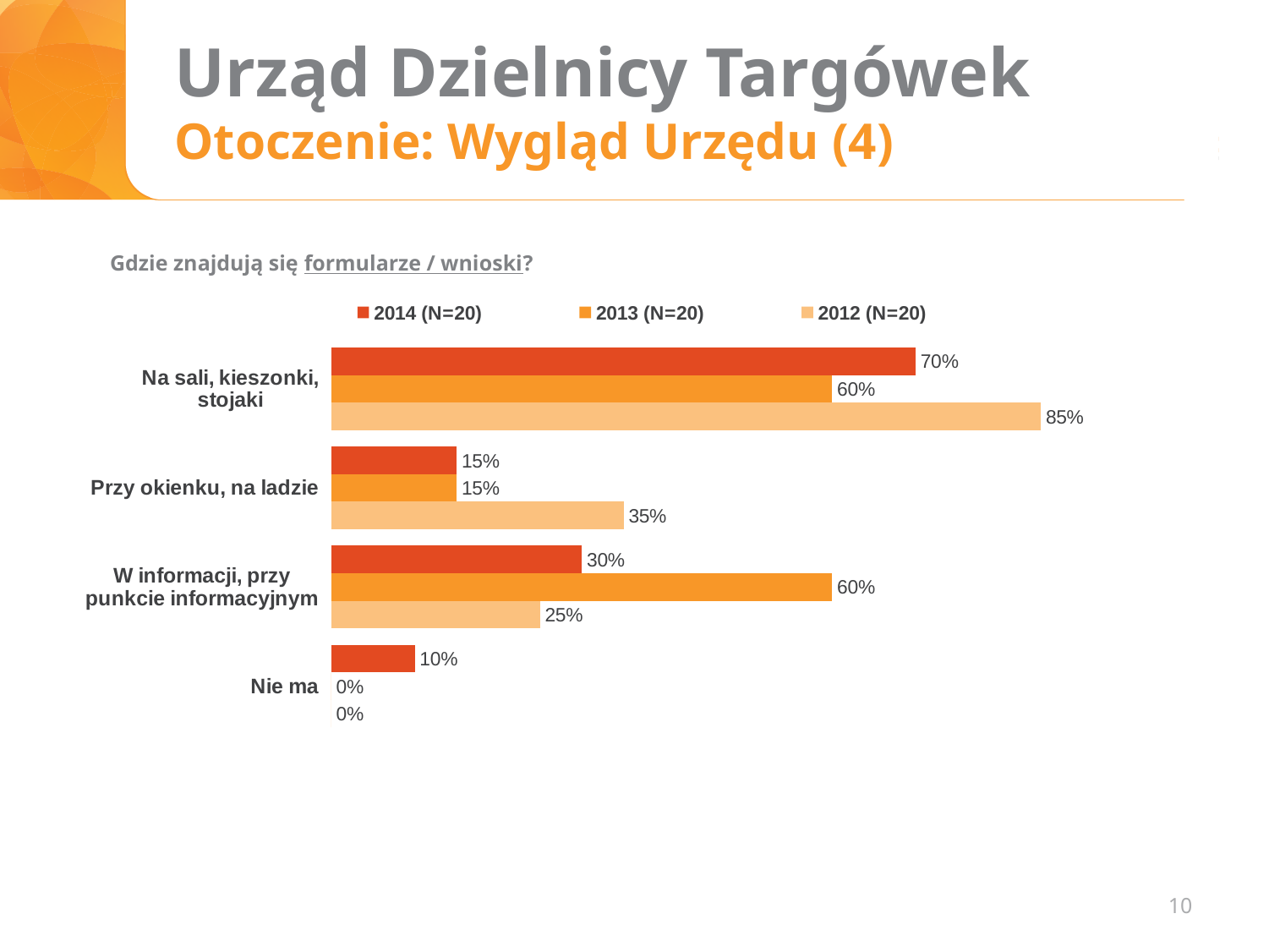
What is the value for 'Nie ma' in the 2014 (N=20) series? 10% Which is larger for 'W informacji, przy punkcie informacyjnym': the 2014 (N=20) value or the 2012 (N=20) value? 2014 (N=20) What question does the chart answer, as stated above it? Gdzie znajdują się formularze / wnioski? How many categories are shown on the chart? 4 Which category has the highest value in the 2012 (N=20) series? Na sali, kieszonki, stojaki How many series does the legend list? 3 What is the value for 'Przy okienku, na ladzie' in the 2012 (N=20) series? 35% What is the difference between the 2012 (N=20) and 2014 (N=20) values for 'Na sali, kieszonki, stojaki'? 15% What kind of chart is shown on the slide? Bar chart What is the value for 'Na sali, kieszonki, stojaki' in the 2014 (N=20) series? 70% What is the value for 'W informacji, przy punkcie informacyjnym' in the 2013 (N=20) series? 60% Which category has the lowest value in the 2014 (N=20) series? Nie ma